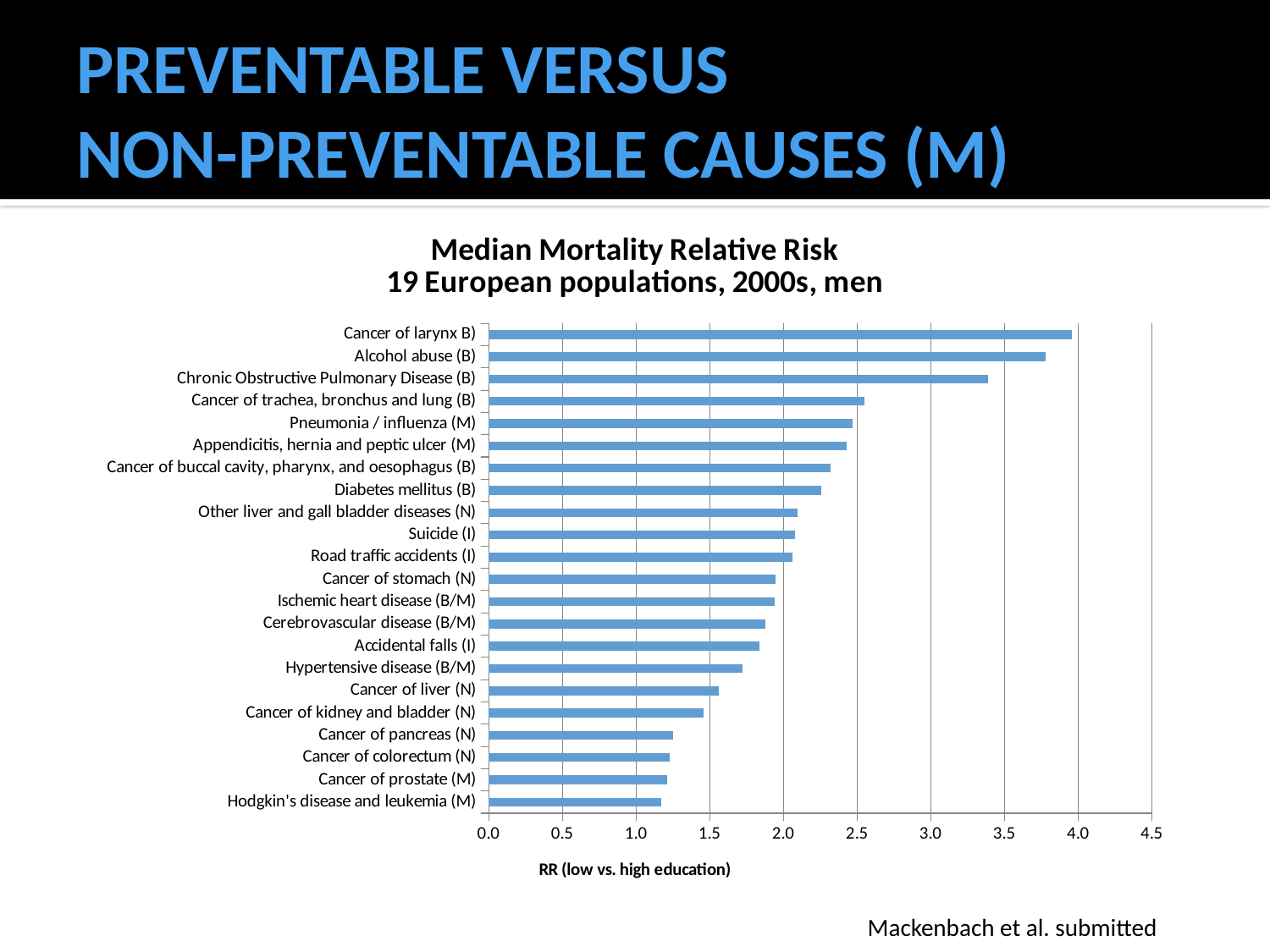
Is the value for Hodgkin's disease and leukemia (M) greater or less than 1.5? less Which has a larger relative risk, Accidental falls (I) or Cancer of kidney and bladder (N)? Accidental falls (I) How many causes of death are listed on the chart? 22 Is the value for Diabetes mellitus (B) greater or less than 2.0? greater Which cause of death has the highest median mortality relative risk? Cancer of larynx B) What is the label of the horizontal axis? RR (low vs. high education) Is the value for Cancer of larynx B greater or less than 3.5? greater What kind of chart is shown on the slide? Bar chart Which cause of death has the lowest median mortality relative risk? Hodgkin's disease and leukemia (M) What is the title of the chart? Median Mortality Relative Risk 19 European populations, 2000s, men Which has a larger relative risk, Alcohol abuse (B) or Chronic Obstructive Pulmonary Disease (B)? Alcohol abuse (B)